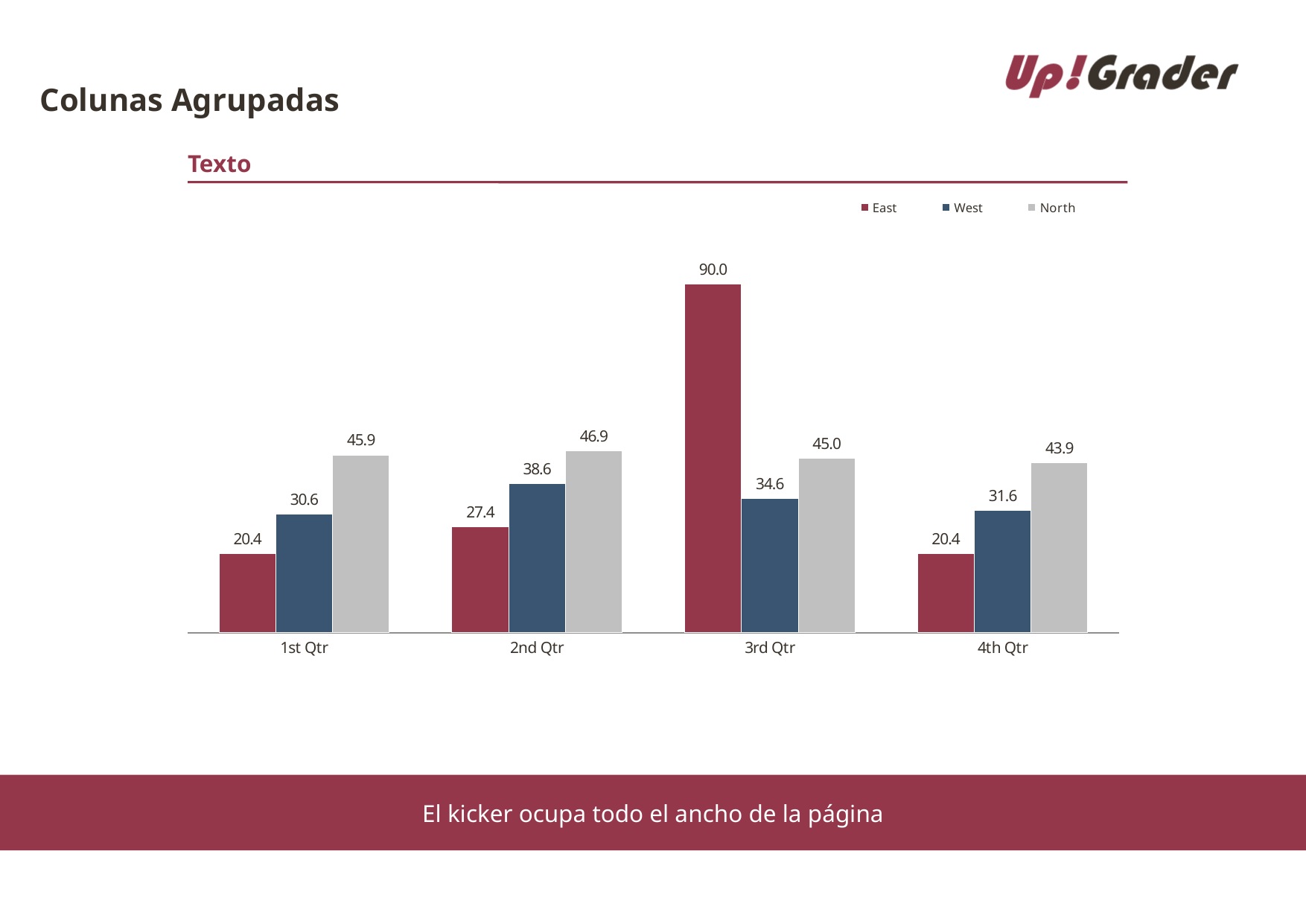
How many series does the legend list? 3 Which quarter has the lowest value for West? 1st Qtr Does the North series rise or fall from 3rd Qtr to 4th Qtr? Fall What is the value for West in 2nd Qtr? 38.6 Which is larger in 4th Qtr, West or North? North What is the value for East in 3rd Qtr? 90.0 What kind of chart is shown on the slide? Bar chart What colour represents the East series in the legend? Dark red What is the value for North in 4th Qtr? 43.9 How many quarters are shown on the x axis? 4 What is the difference between the North and East values in 1st Qtr? 25.5 Which quarter has the highest value for East? 3rd Qtr